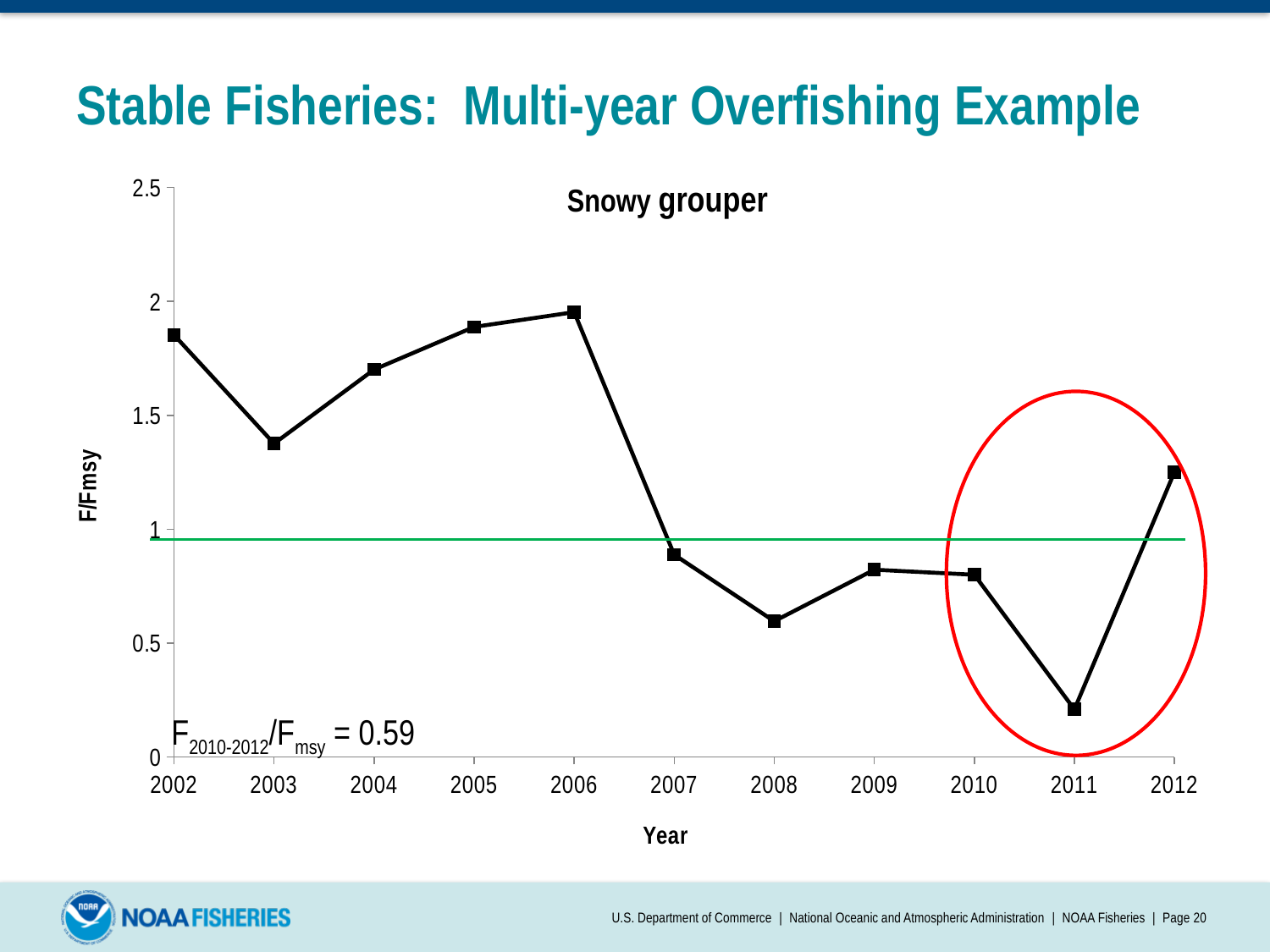
Is the value for 2012 greater or less than 1? greater What is the title of the chart? Snowy grouper Which year has the larger F/Fmsy value, 2005 or 2007? 2005 Is the value for 2002 greater or less than 1.5? greater How many years are plotted on the x axis? 11 In which year is F/Fmsy lowest? 2011 What is the label of the y axis? F/Fmsy Does F/Fmsy rise or fall from 2006 to 2008? Fall In which year is F/Fmsy highest? 2006 Is the value for 2008 greater or less than 1? less What kind of chart is shown on the slide? Line chart